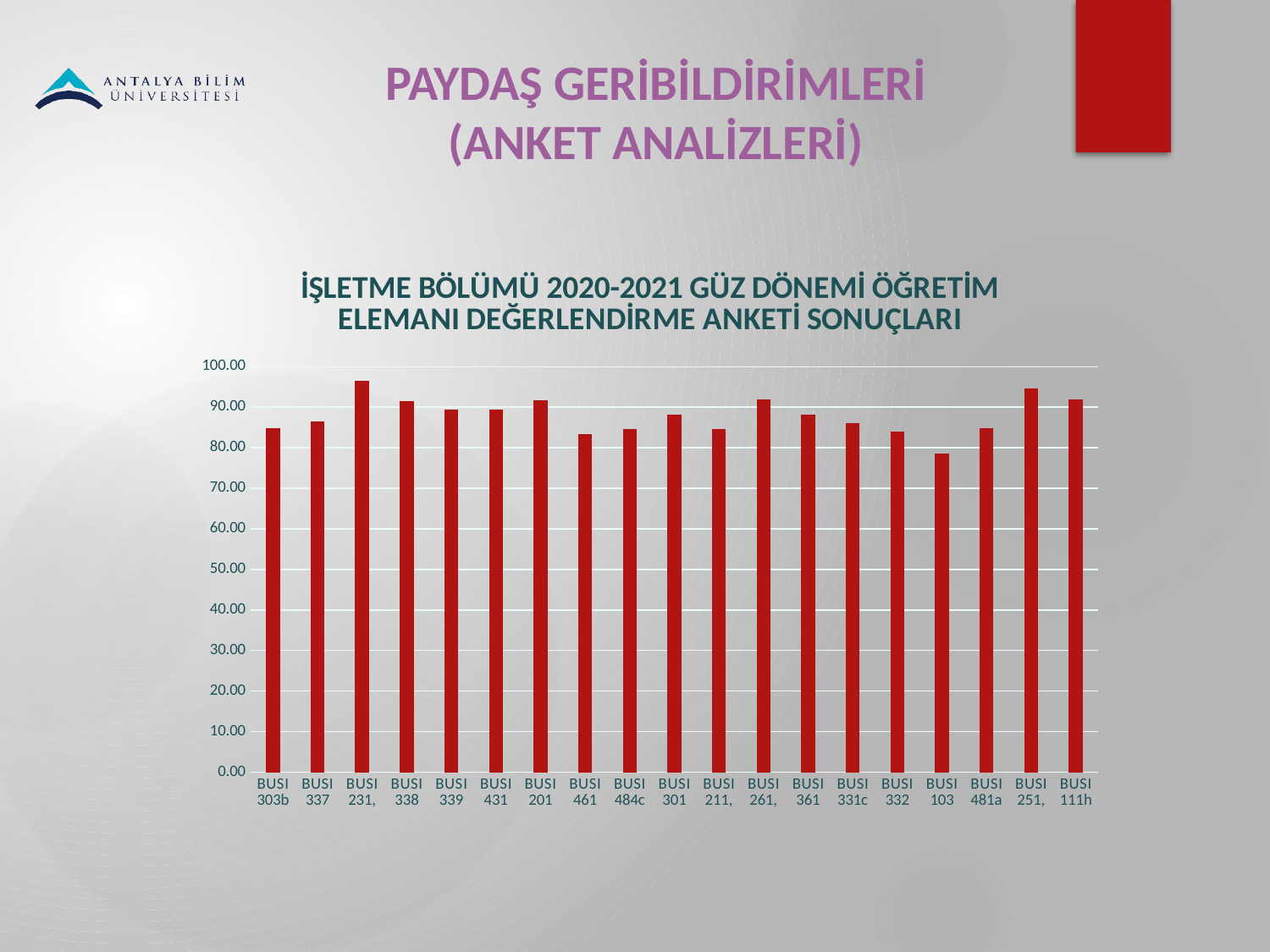
Which is larger, the value for BUSI 338 or the value for BUSI 332? BUSI 338 Is the value for BUSI 103 greater or less than 80? less Which course has the highest value in the chart? BUSI 231 What is the maximum value shown on the vertical axis? 100.00 Which is larger, the value for BUSI 251 or the value for BUSI 461? BUSI 251 What is the title of the chart? İŞLETME BÖLÜMÜ 2020-2021 GÜZ DÖNEMİ ÖĞRETİM ELEMANI DEĞERLENDİRME ANKETİ SONUÇLARI How many courses (bars) are shown in the chart? 19 Is the value for BUSI 303b greater or less than 90? less Is the value for BUSI 231 greater or less than 90? greater What kind of chart is shown on the slide? bar chart Which course has the lowest value in the chart? BUSI 103